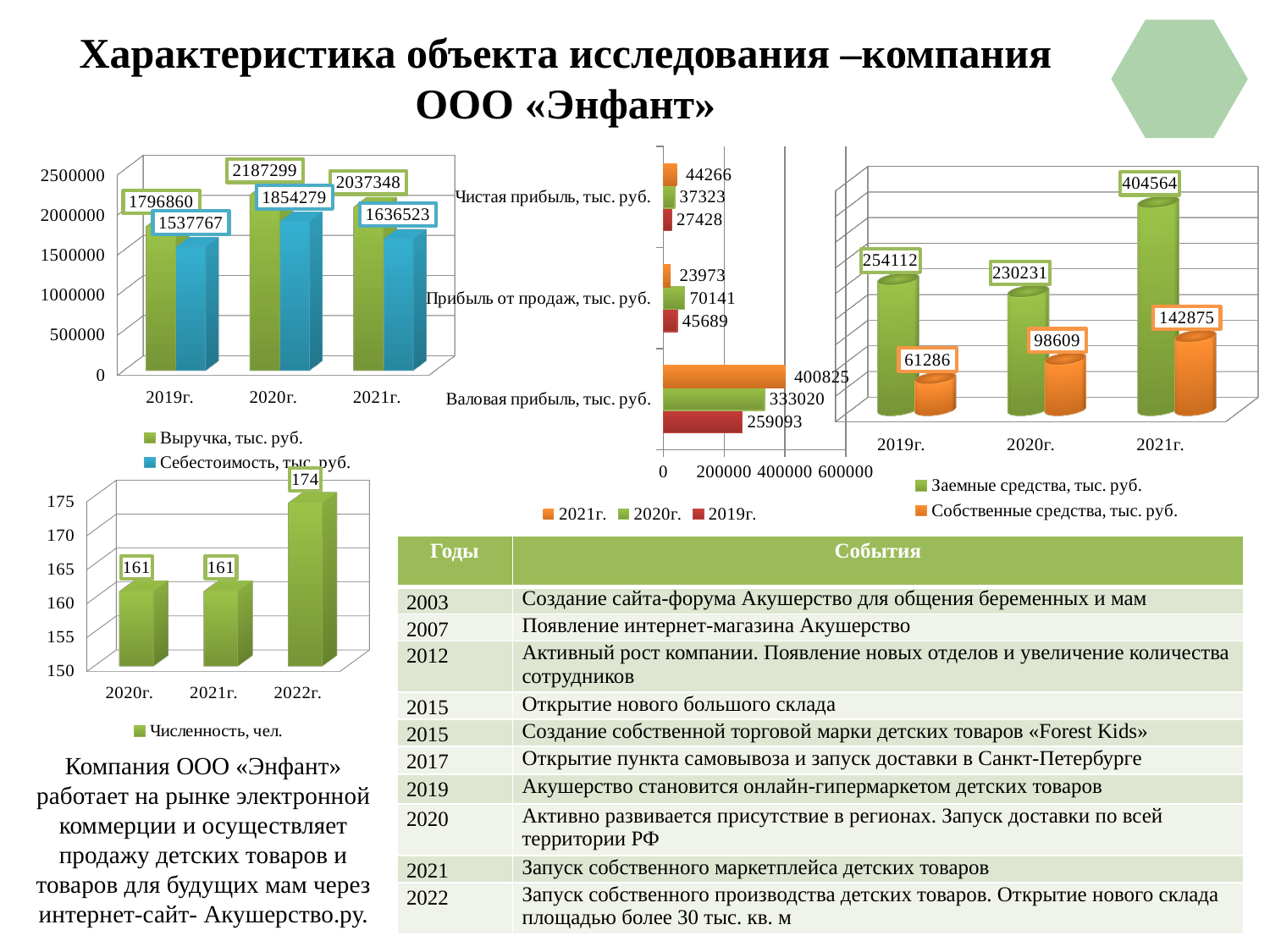
In the bottom-left chart, how many years are shown on the x axis? 3 What kind of chart is the right chart showing Заемные средства and Собственные средства? bar chart In the right chart, what is the value of Заемные средства, тыс. руб. for 2021г.? 404564 In the top-left chart, which year has the highest Выручка, тыс. руб.? 2020г. In the top-left chart, what is the difference between Выручка and Себестоимость for 2019г.? 259093 In the top-left chart, what is the value of Выручка, тыс. руб. for 2020г.? 2187299 In the middle horizontal bar chart, what is the value of Прибыль от продаж, тыс. руб. for 2020г.? 70141 In the right chart, which year has the lowest Собственные средства, тыс. руб.? 2019г. In the bottom-left chart, what is the value of Численность, чел. for 2022г.? 174 In the top-left chart, what is the value of Себестоимость, тыс. руб. for 2021г.? 1636523 In the middle horizontal bar chart, what is the value of Валовая прибыль, тыс. руб. for 2021г.? 400825 In the middle horizontal bar chart, how many series does the legend list? 3